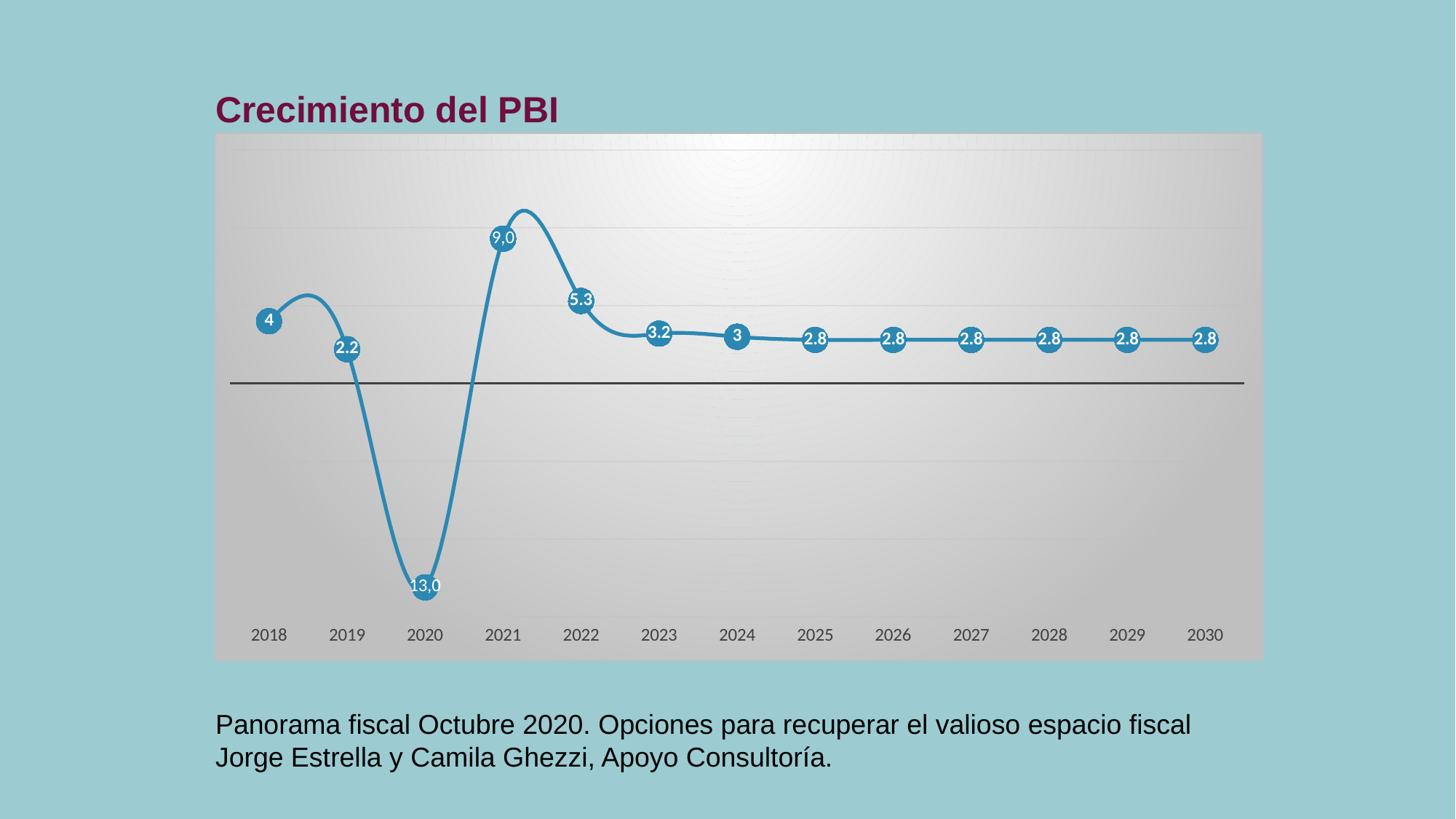
What is the value plotted for 2019? 2.2 Do the values rise or fall from 2022 to 2025? fall What is the value plotted for 2022? 5.3 What is the value plotted for 2024? 3 What is the title of the chart? Crecimiento del PBI Which year has the lowest point on the line? 2020 Which is larger, the value for 2023 or the value for 2025? 2023 What type of chart is shown on the slide? line chart Which year has the highest point on the line? 2021 What is the value plotted for 2018? 4 What is the difference between the values for 2021 and 2022? 3.7 How many years are plotted on the x axis? 13